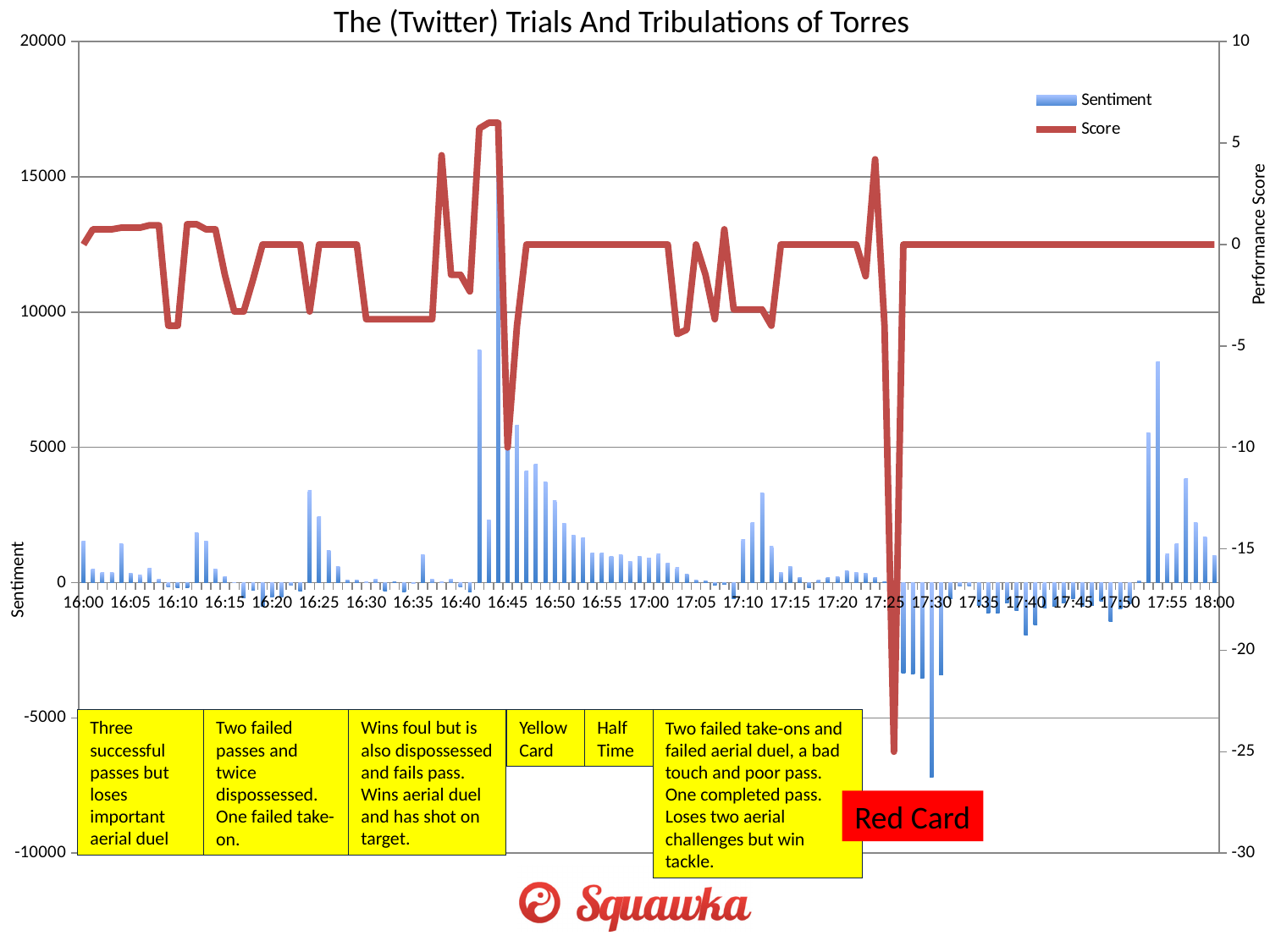
What is the title of the chart? The (Twitter) Trials And Tribulations of Torres How many series does the legend list? 2 Is the Sentiment value at 16:44 greater or less than 10000? greater Which is larger, the Sentiment value at 16:44 or the Sentiment value at 17:54? 16:44 Is the highest Score value (around 16:43) greater or less than 5? greater Is the Sentiment value at 17:54 greater or less than 5000? greater What kind of chart is this? A combination chart with bars (Sentiment) and a line (Score) Which series is plotted as a line? Score How many time labels are shown on the x axis? 25